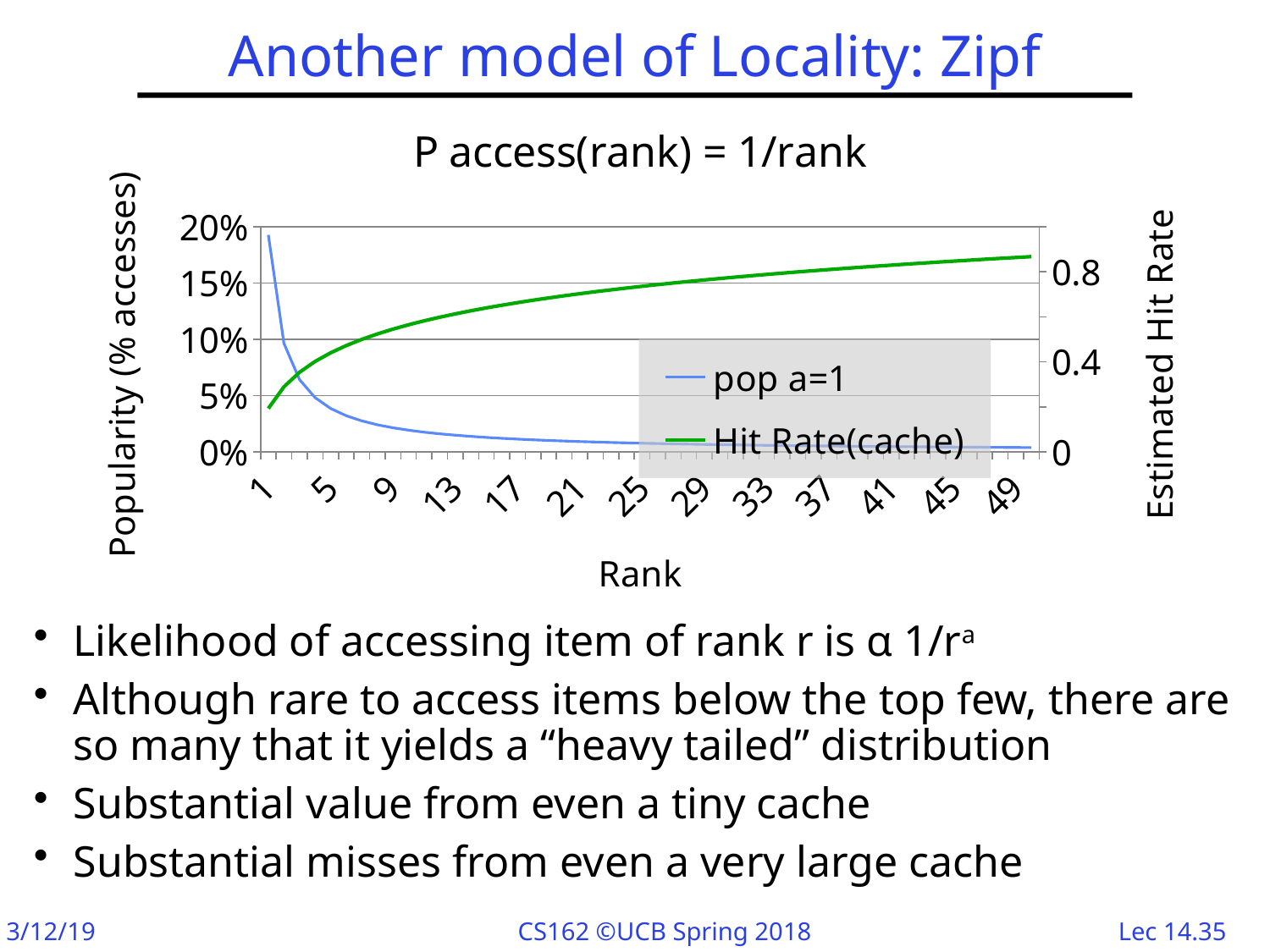
What is the label of the x axis of the chart? Rank Is the value of 'pop a=1' at rank 25 greater or less than 5%? less Does the 'Hit Rate(cache)' series rise or fall as rank increases? rise What is the title of the chart? P access(rank) = 1/rank What kind of chart is shown on the slide? line chart Is the value of 'Hit Rate(cache)' at rank 25 greater or less than 0.4? greater Does the 'pop a=1' series rise or fall as rank increases? fall Is the value of 'Hit Rate(cache)' at rank 49 greater or less than 0.8? greater How many series does the chart's legend list? 2